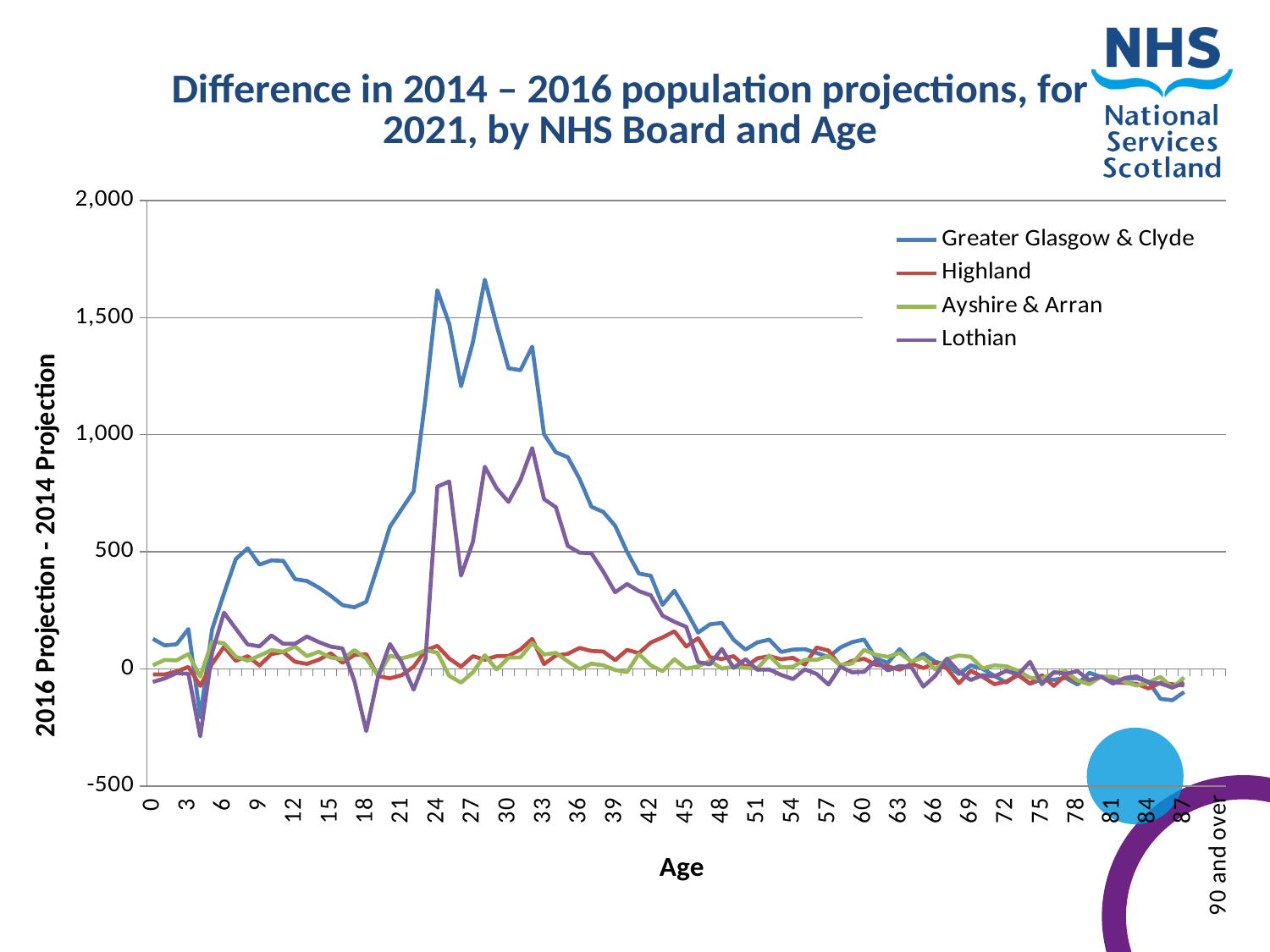
Is the value for Lothian at age 33 greater or less than 1,000? less Does the Greater Glasgow & Clyde line rise or fall between age 33 and age 60? fall What is the label on the vertical axis? 2016 Projection - 2014 Projection Is the value for Greater Glasgow & Clyde at age 36 greater or less than 500? greater What is the title of the chart? Difference in 2014 – 2016 population projections, for 2021, by NHS Board and Age How many series does the legend list? 4 Is the value for Lothian at age 24 greater or less than 500? greater Which series reaches the highest value on the chart? Greater Glasgow & Clyde What kind of chart is shown on the slide? Line chart At age 28, which is larger: the value for Greater Glasgow & Clyde or the value for Lothian? Greater Glasgow & Clyde